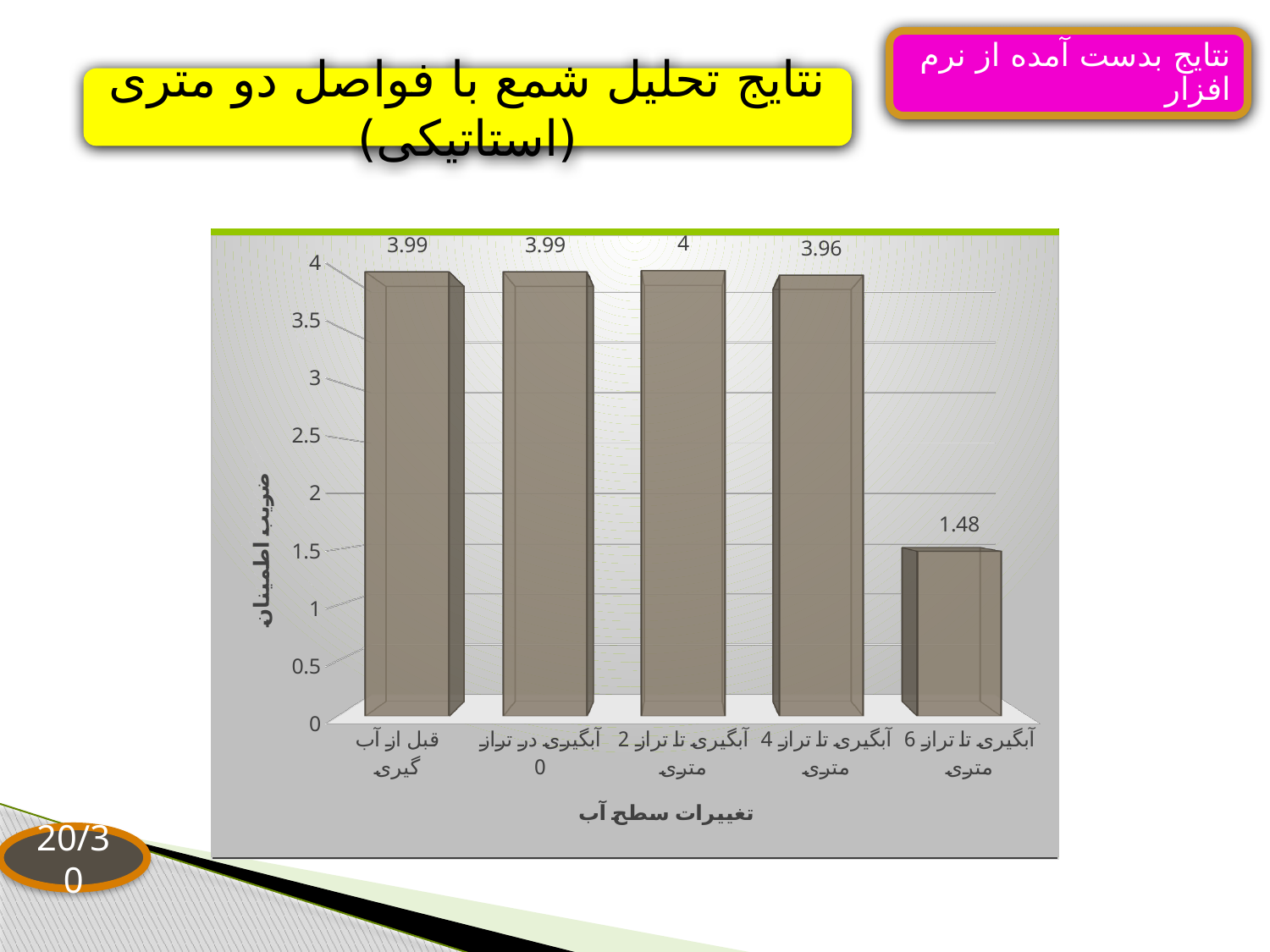
Is the value for "آبگیری تا تراز 6 متری" greater or less than 2? less What is the label of the vertical axis? ضریب اطمینان Which category has the highest value? آبگیری تا تراز 2 متری What is the difference between the values for "آبگیری تا تراز 4 متری" and "آبگیری تا تراز 6 متری"? 2.48 What is the value for the category "آبگیری تا تراز 6 متری"? 1.48 Which category has the lowest value? آبگیری تا تراز 6 متری How many categories are shown on the x axis? 5 Which is larger, the value for "آبگیری تا تراز 2 متری" or the value for "آبگیری تا تراز 4 متری"? آبگیری تا تراز 2 متری What is the value for the category "آبگیری تا تراز 2 متری"? 4 What is the value for the category "آبگیری تا تراز 4 متری"? 3.96 What kind of chart is shown on the slide? bar chart What is the value for the category "قبل از آب گیری"? 3.99